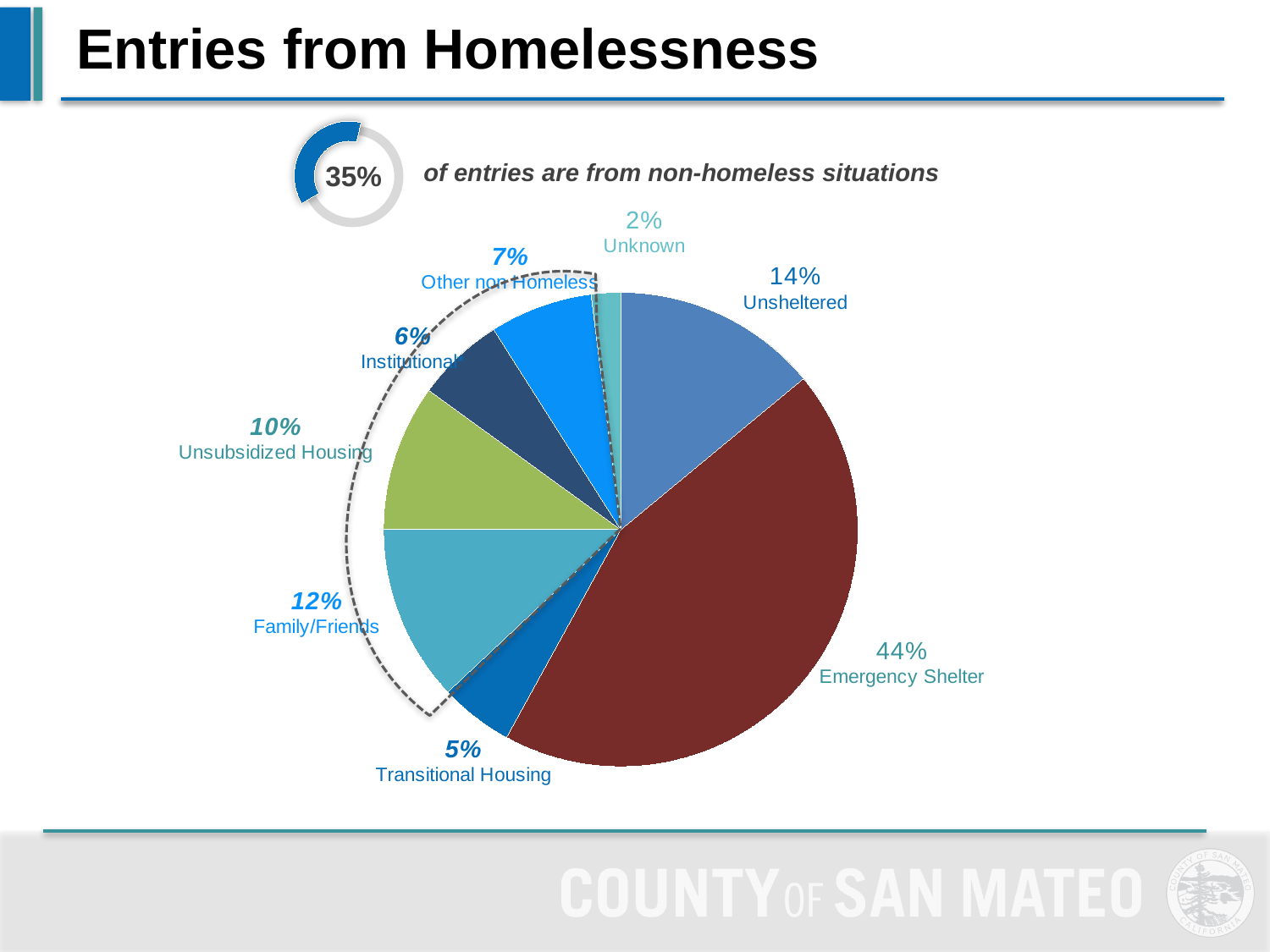
What is the title of the slide? Entries from Homelessness What percentage of entries are from Emergency Shelter? 44% What kind of chart is shown on the slide? pie chart What percentage of entries are from Family/Friends? 12% Which category has the smallest share of the pie? Unknown Which is larger, the share for Family/Friends or the share for Unsubsidized Housing? Family/Friends What is the combined share of Other non-Homeless, Institutional, Unsubsidized Housing and Family/Friends? 35% What percentage of entries are from Transitional Housing? 5% Which category has the largest share of the pie? Emergency Shelter What percentage of entries are from Unsheltered situations? 14% How many categories are shown in the pie chart? 8 How many percentage points larger is the Emergency Shelter share than the Unsheltered share? 30